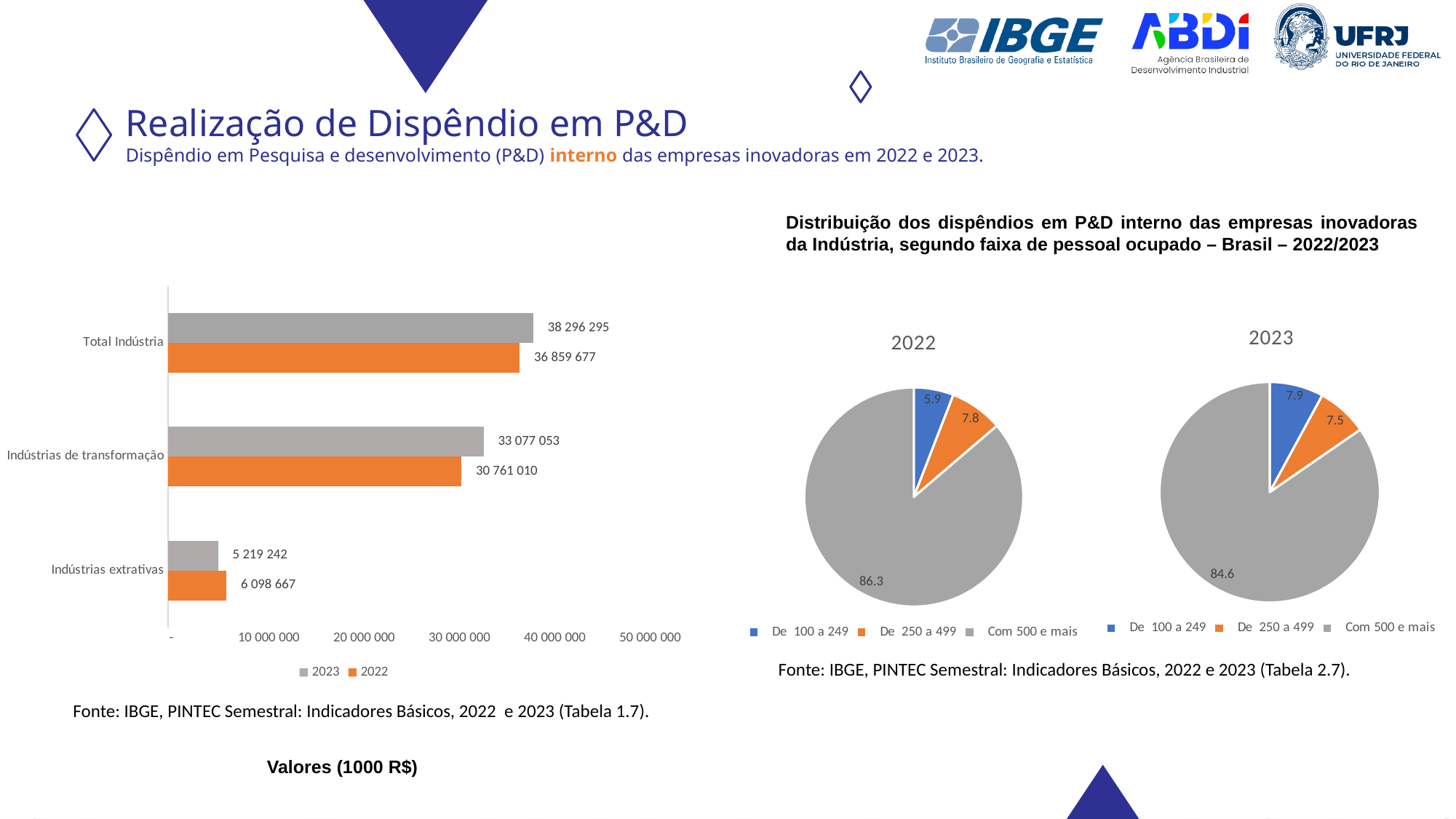
What kind of chart is shown on the left of the slide? bar chart In the bar chart on the left, how many series does the legend list? 2 In the bar chart on the left, what is the difference between the 2023 and 2022 values for Total Indústria? 1 436 618 In the 2023 pie chart, what share is shown for De 100 a 249? 7.9 In the 2022 pie chart, how many slices are there? 3 In the 2022 pie chart, what share is shown for Com 500 e mais? 86.3 In the bar chart on the left, which category has the lowest 2023 value? Indústrias extrativas In the bar chart on the left, what is the 2023 value for Total Indústria? 38 296 295 In the bar chart on the left, is the 2022 value for Indústrias extrativas larger or smaller than the 2023 value? larger In the bar chart on the left, what is the 2022 value for Indústrias de transformação? 30 761 010 In the 2023 pie chart, which slice is the largest? Com 500 e mais In the bar chart on the left, what is the 2022 value for Indústrias extrativas? 6 098 667